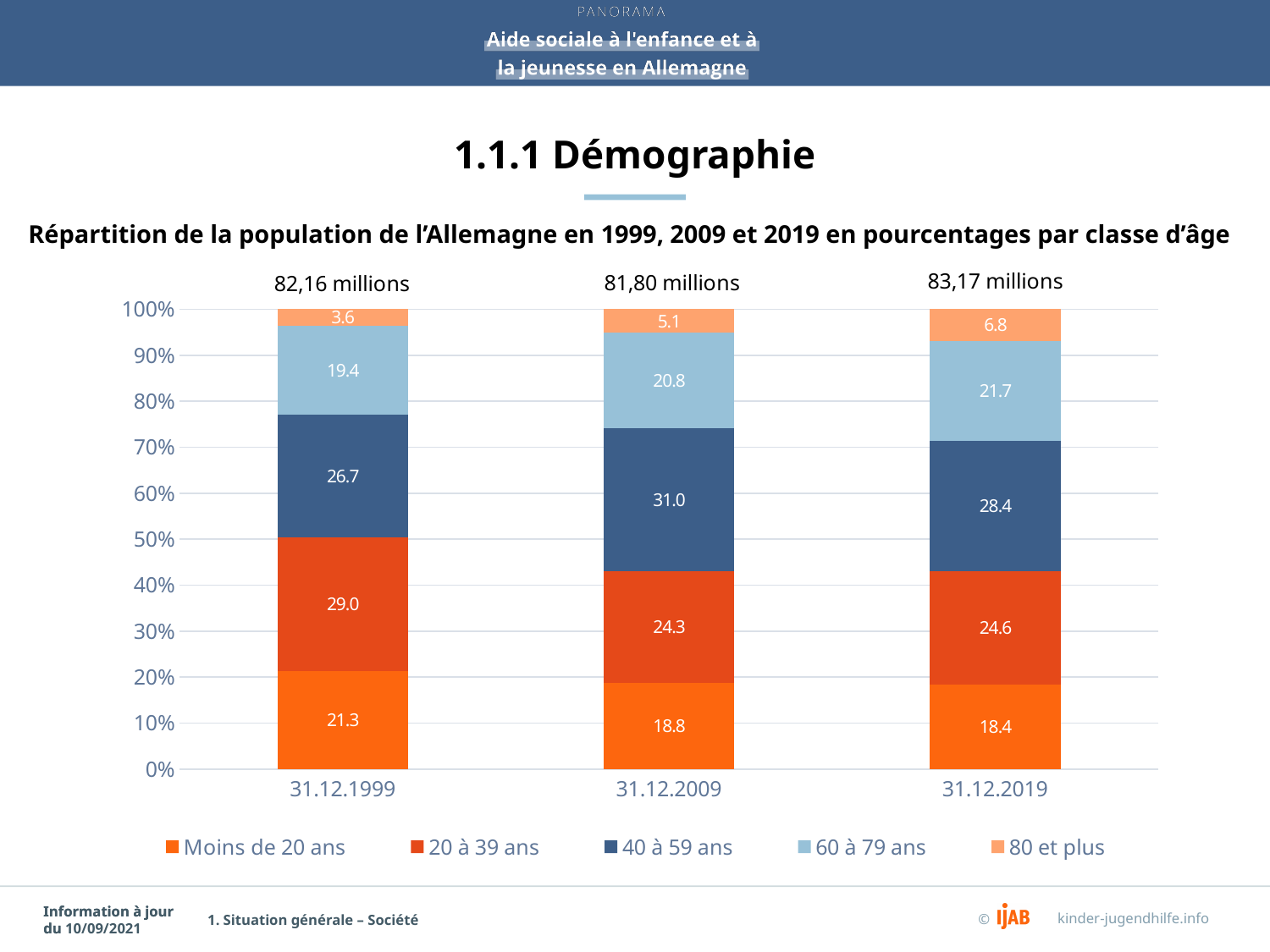
What total population is printed above the 31.12.2019 bar? 83,17 millions How many dates (bars) are shown on the x axis? 3 What is the value for the '40 à 59 ans' segment in the 31.12.2009 bar? 31.0 Does the '80 et plus' share rise or fall from 31.12.1999 to 31.12.2019? Rise What is the value for 'Moins de 20 ans' in the 31.12.2019 bar? 18.4 Which date has the lowest value for 'Moins de 20 ans'? 31.12.2019 Which has the larger '60 à 79 ans' value, 31.12.2009 or 31.12.2019? 31.12.2019 What is the value for the '80 et plus' segment in the 31.12.1999 bar? 3.6 What is the difference between the '20 à 39 ans' values for 31.12.1999 and 31.12.2009? 4.7 Which date has the highest value for '80 et plus'? 31.12.2019 How many series does the legend list? 5 What kind of chart is shown on the slide? Stacked bar chart